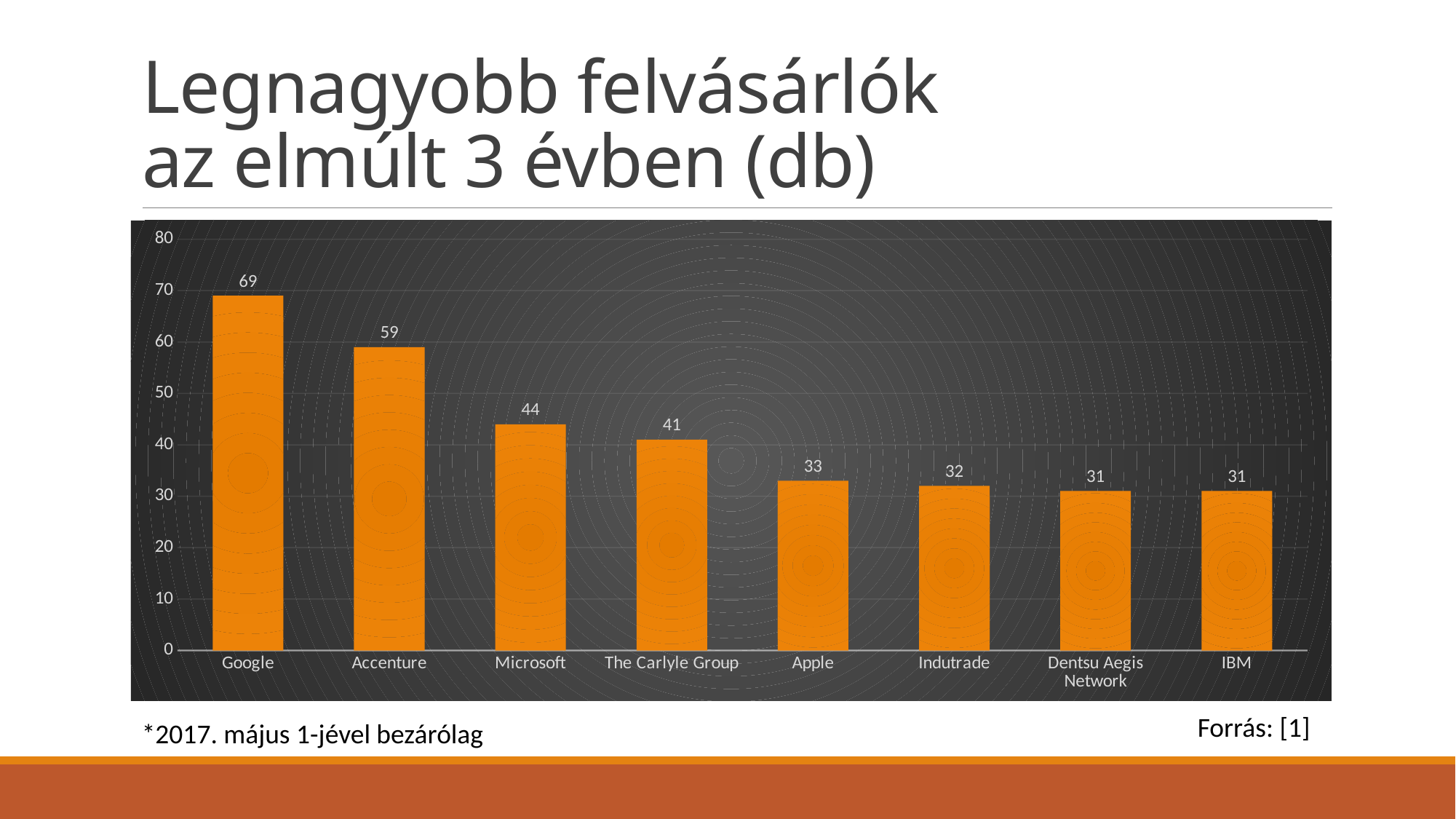
What is the value for Google? 69 What kind of chart is shown on the slide? bar chart What is the value for Microsoft? 44 Is the value for The Carlyle Group greater or less than 50? less Which is larger, the value for Accenture or the value for Indutrade? Accenture Which company has the highest value? Google What is the difference between the values for Google and Accenture? 10 What is the value for Apple? 33 What is the difference between the values for Microsoft and The Carlyle Group? 3 Do the values rise or fall from left to right along the x axis? fall What is the value for IBM? 31 How many companies are shown on the chart? 8